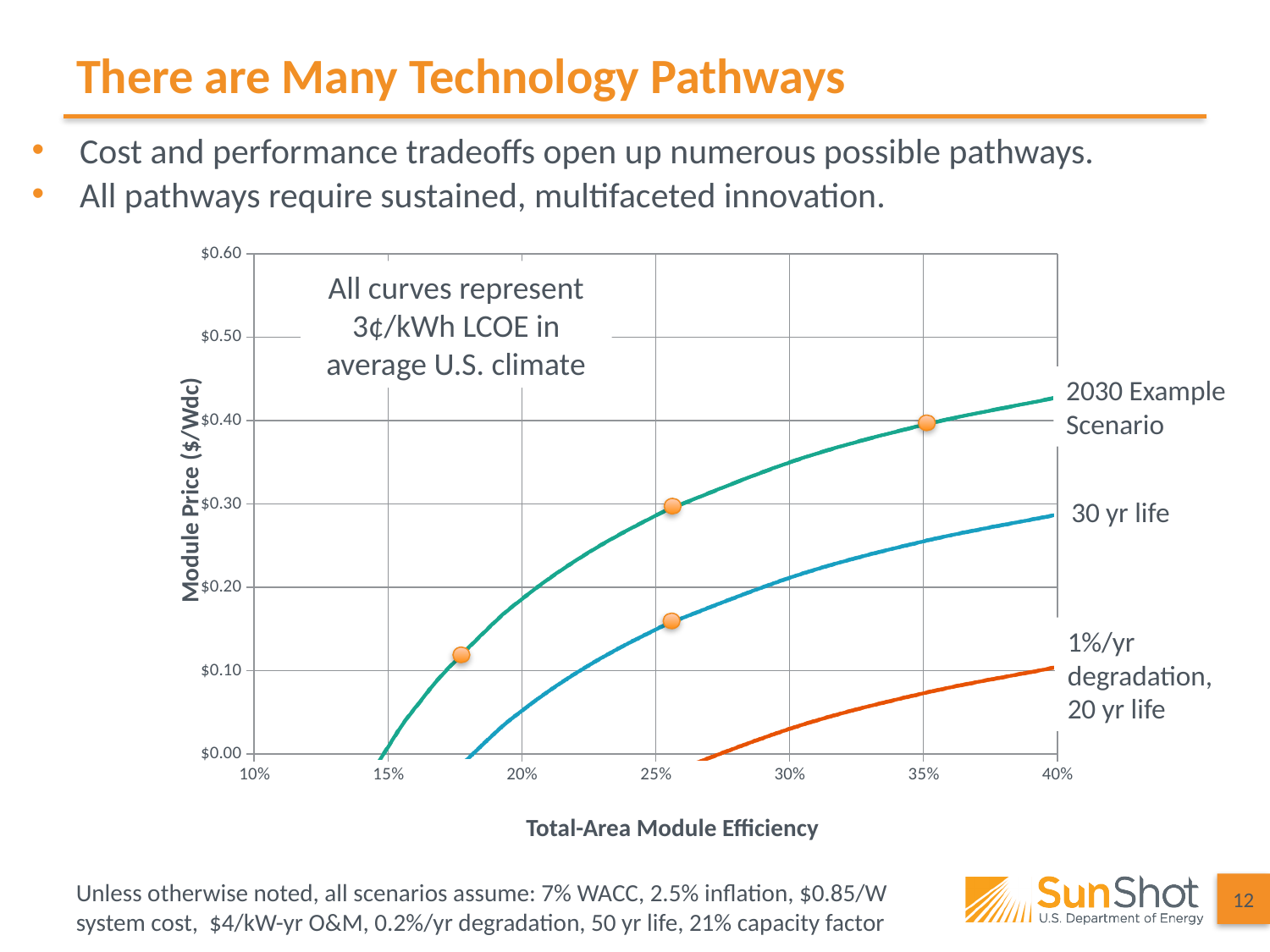
Is the module price for the 30 yr life curve at 25% efficiency greater or less than $0.20? less Which curve is highest at 30% total-area module efficiency? 2030 Example Scenario Is the module price for the 2030 Example Scenario curve at 40% efficiency greater or less than $0.40? greater What LCOE do all curves on the chart represent, according to the annotation? 3¢/kWh LCOE in average U.S. climate What kind of chart is shown on the slide? line chart Which curve is lowest at 35% total-area module efficiency? 1%/yr degradation, 20 yr life Do the curves rise or fall as total-area module efficiency increases? rise How many curves are plotted on the chart? 3 At 35% efficiency, which curve has the higher module price: 30 yr life or 1%/yr degradation, 20 yr life? 30 yr life Is the module price for the 30 yr life curve at 40% efficiency greater or less than $0.40? less What is the label of the chart's y axis? Module Price ($/Wdc)